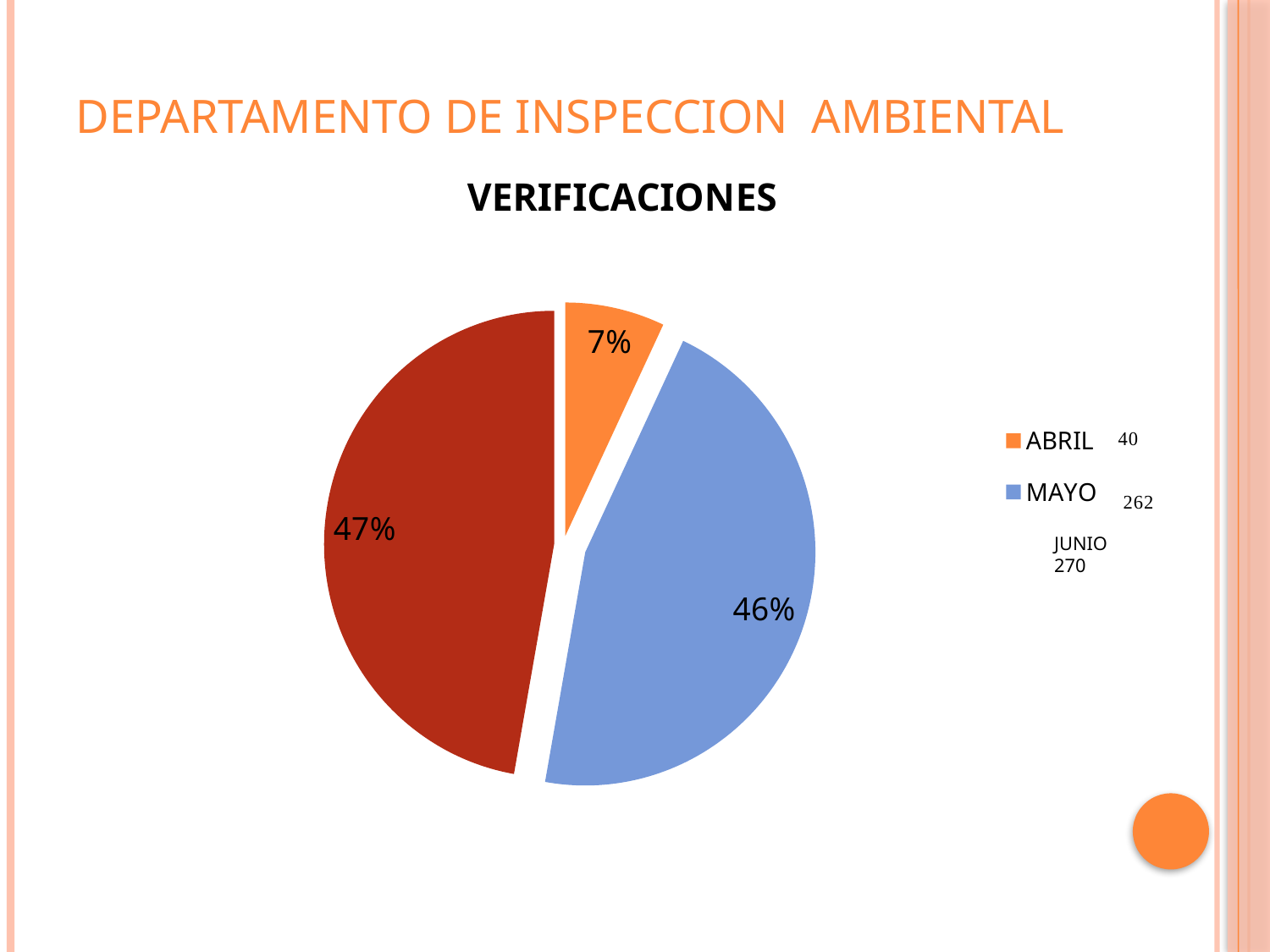
What kind of chart is shown on the slide? pie chart What is the difference in percentage points between the MAYO slice and the ABRIL slice? 39% What percentage of the pie does ABRIL represent? 7% Which slice is larger, MAYO or ABRIL? MAYO Which month has the largest slice of the pie? JUNIO What is the title of the chart? VERIFICACIONES Which month has the smallest slice of the pie? ABRIL What colour is the ABRIL slice? orange What number is printed next to ABRIL in the legend? 40 What percentage of the pie does MAYO represent? 46% What percentage of the pie does JUNIO represent? 47% How many slices does the pie chart have? 3